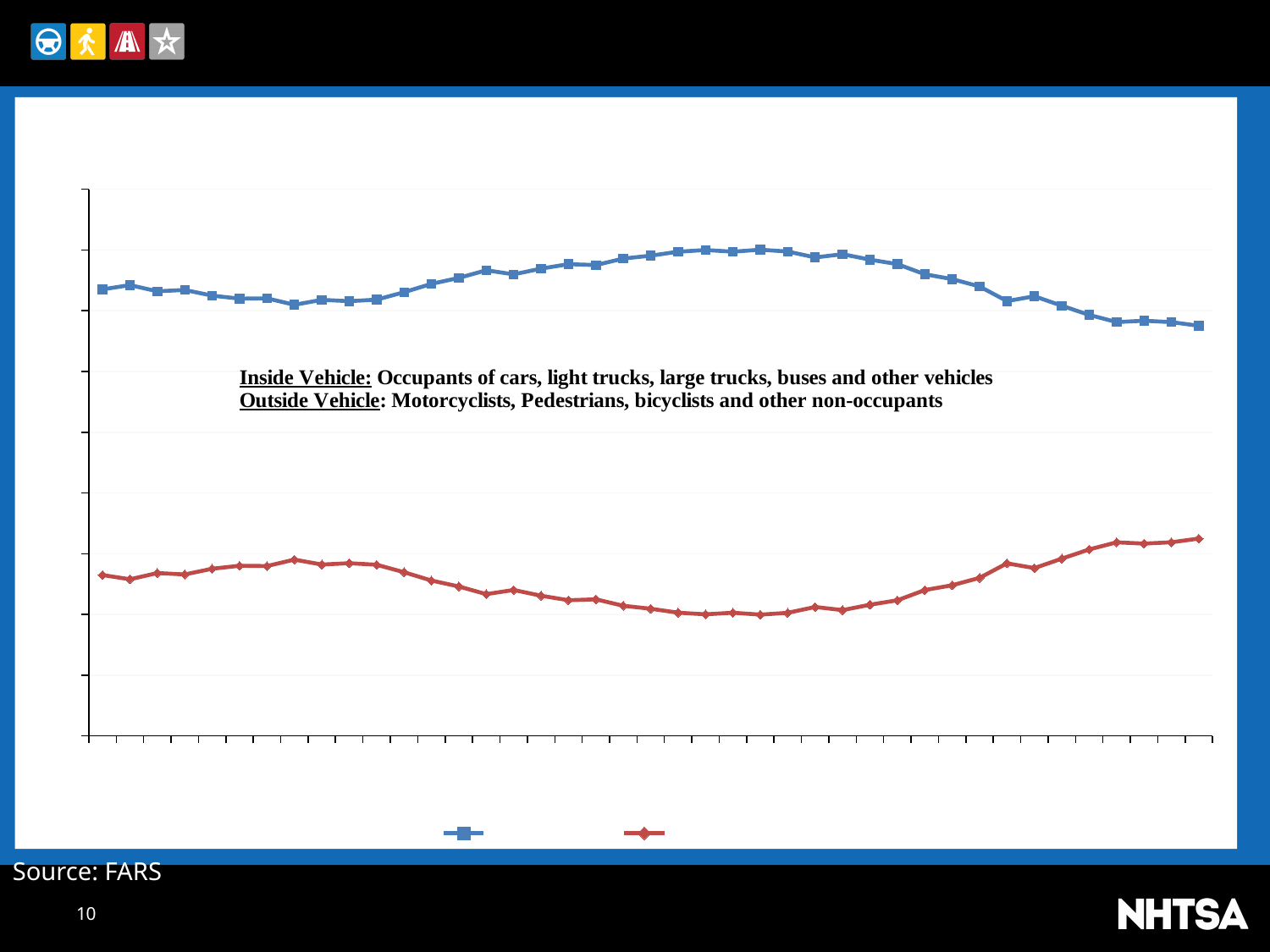
Over the right-hand portion of the chart, is the blue series rising or falling? Falling What marker shape is used for the blue series? Squares Does the blue series end higher or lower than where it starts on the left? Lower Which series is plotted higher on the chart, the blue line or the red line? The blue line Over the right-hand portion of the chart, is the red series rising or falling? Rising How many series does the legend list? 2 Where along the x axis does the blue series reach its highest point: near the left, the middle, or the right? Near the middle According to the note on the chart, who is included in 'Outside Vehicle'? Motorcyclists, Pedestrians, bicyclists and other non-occupants What kind of chart is shown on the slide? Line chart Where along the x axis does the red series reach its lowest point: near the left, the middle, or the right? Near the middle